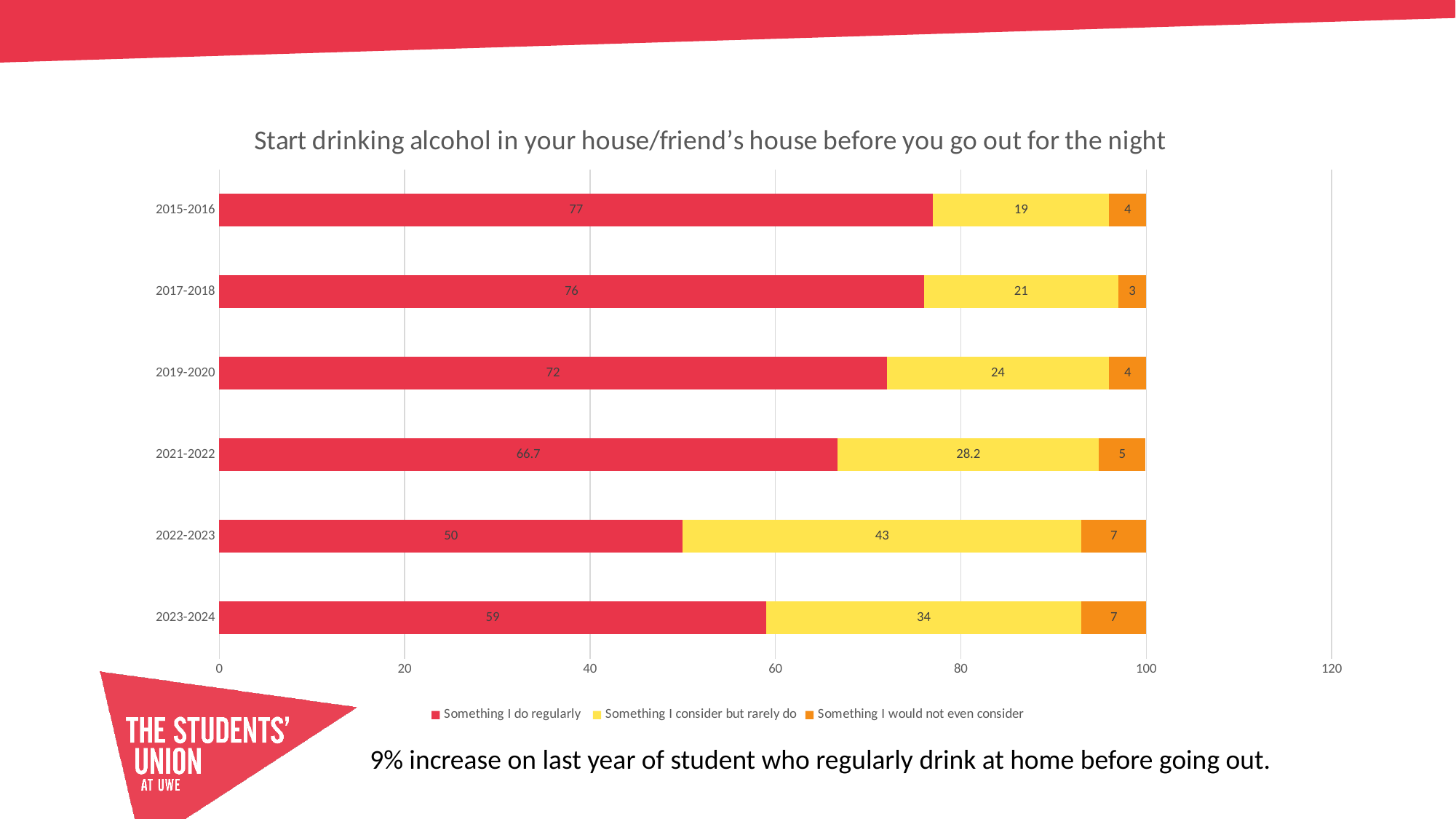
Which is larger: "Something I consider but rarely do" in 2019-2020 or in 2017-2018? 2019-2020 What is the value for "Something I consider but rarely do" in 2022-2023? 43 What is the title of the chart? Start drinking alcohol in your house/friend's house before you go out for the night Which year has the lowest value for "Something I do regularly"? 2022-2023 What is the value for "Something I would not even consider" in 2021-2022? 5 What kind of chart is shown on the slide? Stacked bar chart Which year has the highest value for "Something I do regularly"? 2015-2016 What is the total of the stacked bar for 2021-2022? 99.9 How many series does the legend list? 3 How many year categories are shown on the chart? 6 What is the value for "Something I do regularly" in 2015-2016? 77 What is the difference between the "Something I do regularly" values for 2023-2024 and 2022-2023? 9